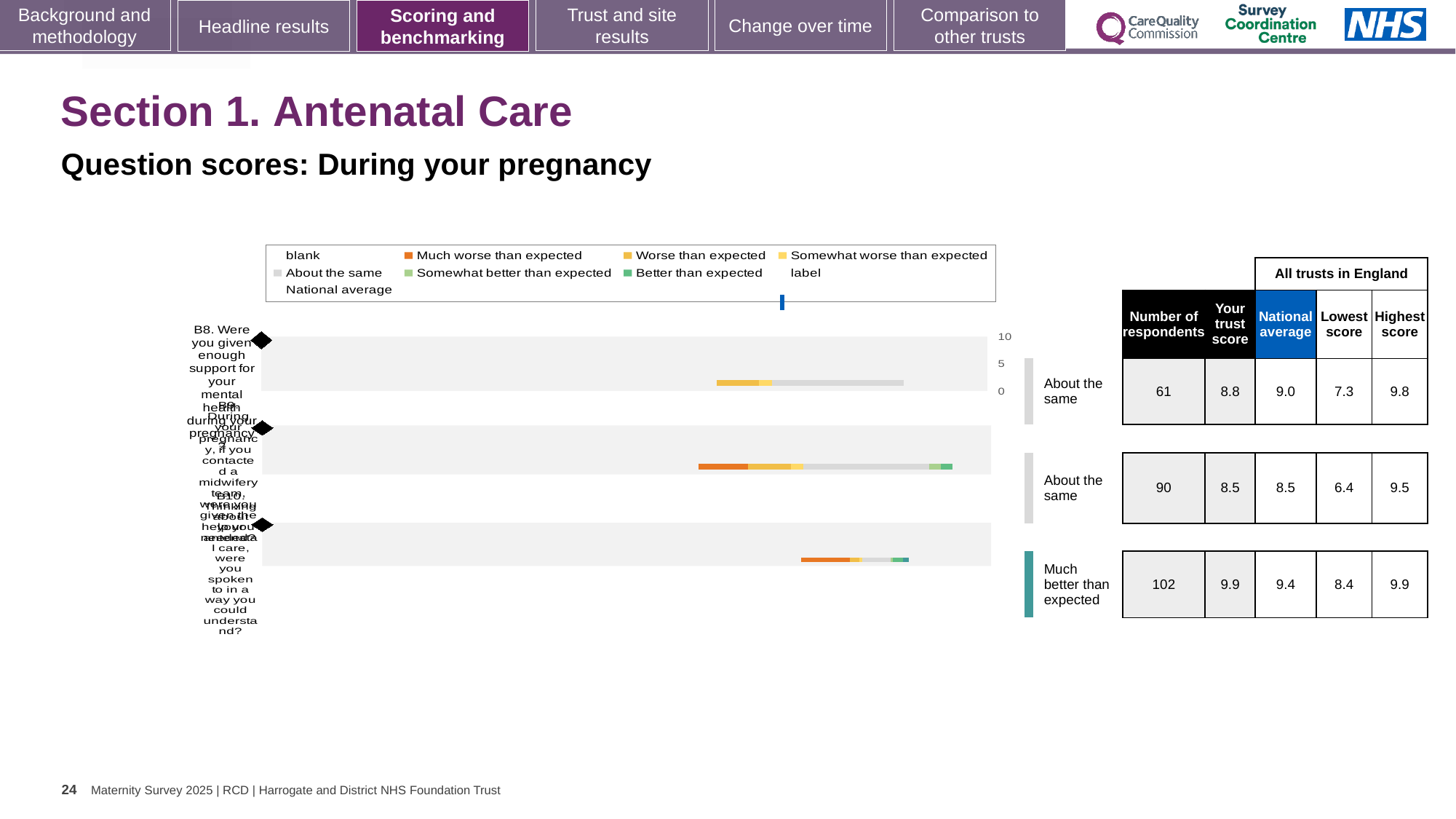
Which row of the table has the highest number of respondents? the third row (Much better than expected), 102 How many questions (bars) are plotted in the chart? 3 What is the difference between the highest score and the lowest score in the second row of the table? 3.1 In the table, what is the number of respondents for the first row (B8, support for your mental health during pregnancy)? 61 For the first row (B8), is the trust score higher or lower than the national average? lower Which row of the table has the lowest 'Lowest score' value? the second row, 6.4 What colour represents 'Much worse than expected' in the chart legend? orange What kind of chart is shown on the slide? bar chart In the table, what is the national average for the second row? 8.5 What benchmark category is shown for the third question in the chart? Much better than expected In the table, what is the highest score for the first row (B8)? 9.8 In the table, what is the 'Your trust score' for the third row (the 'Much better than expected' row)? 9.9